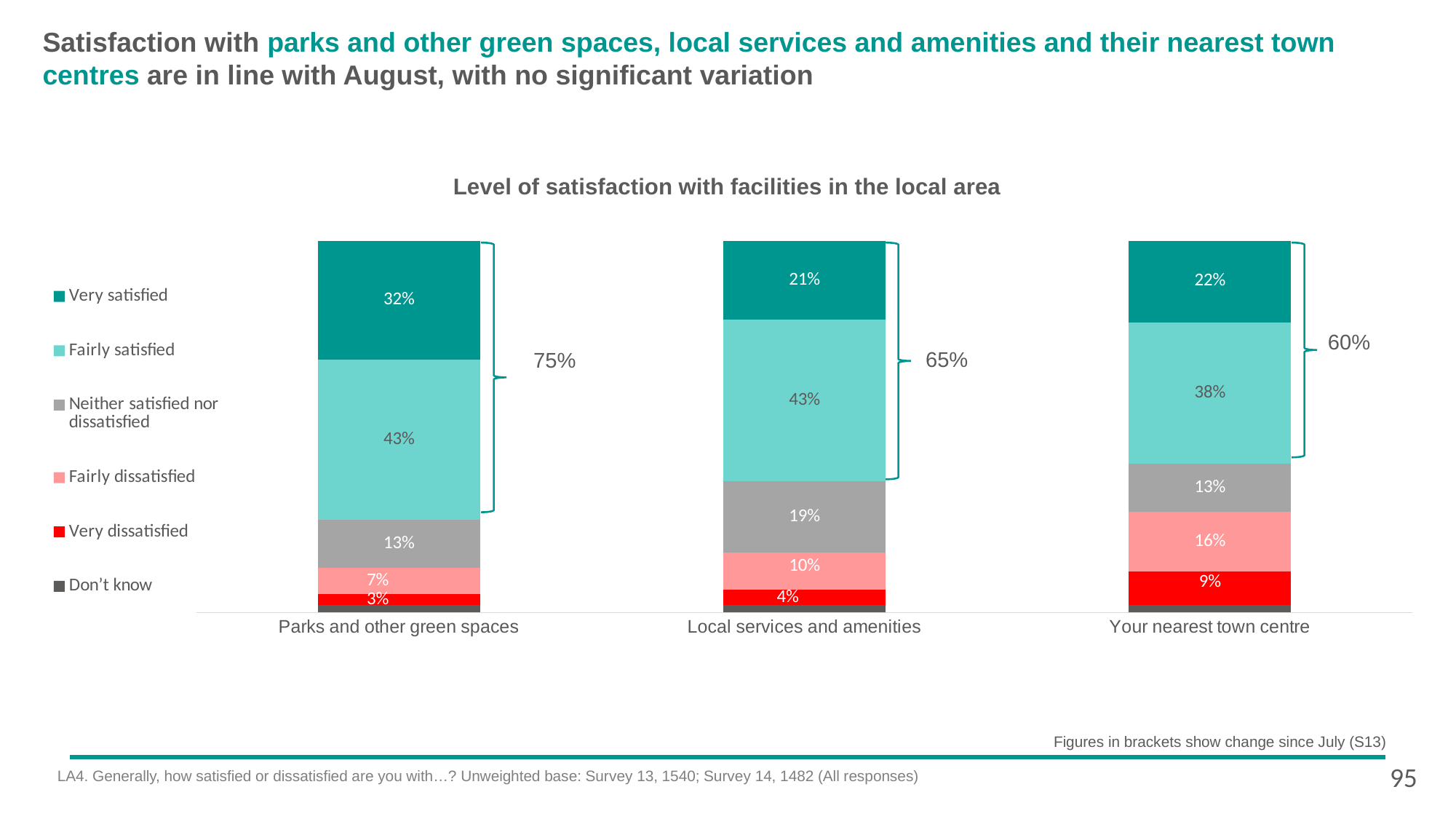
Which facility has the highest very satisfied percentage? Parks and other green spaces What percentage of respondents are fairly dissatisfied with their nearest town centre? 16% What percentage of respondents are fairly satisfied with local services and amenities? 43% What percentage of respondents are very satisfied with parks and other green spaces? 32% What type of chart is shown on the slide? Stacked bar chart What is the combined satisfied (very plus fairly satisfied) percentage shown by the bracket for parks and other green spaces? 75% Is the very dissatisfied percentage larger for your nearest town centre or for local services and amenities? Your nearest town centre How many series does the legend list? 6 What is the difference between the very satisfied percentages for parks and other green spaces and local services and amenities? 11 percentage points Which facility has the lowest combined satisfied percentage shown by the brackets? Your nearest town centre How many facility categories are shown on the x axis? 3 What percentage of respondents are neither satisfied nor dissatisfied with local services and amenities? 19%